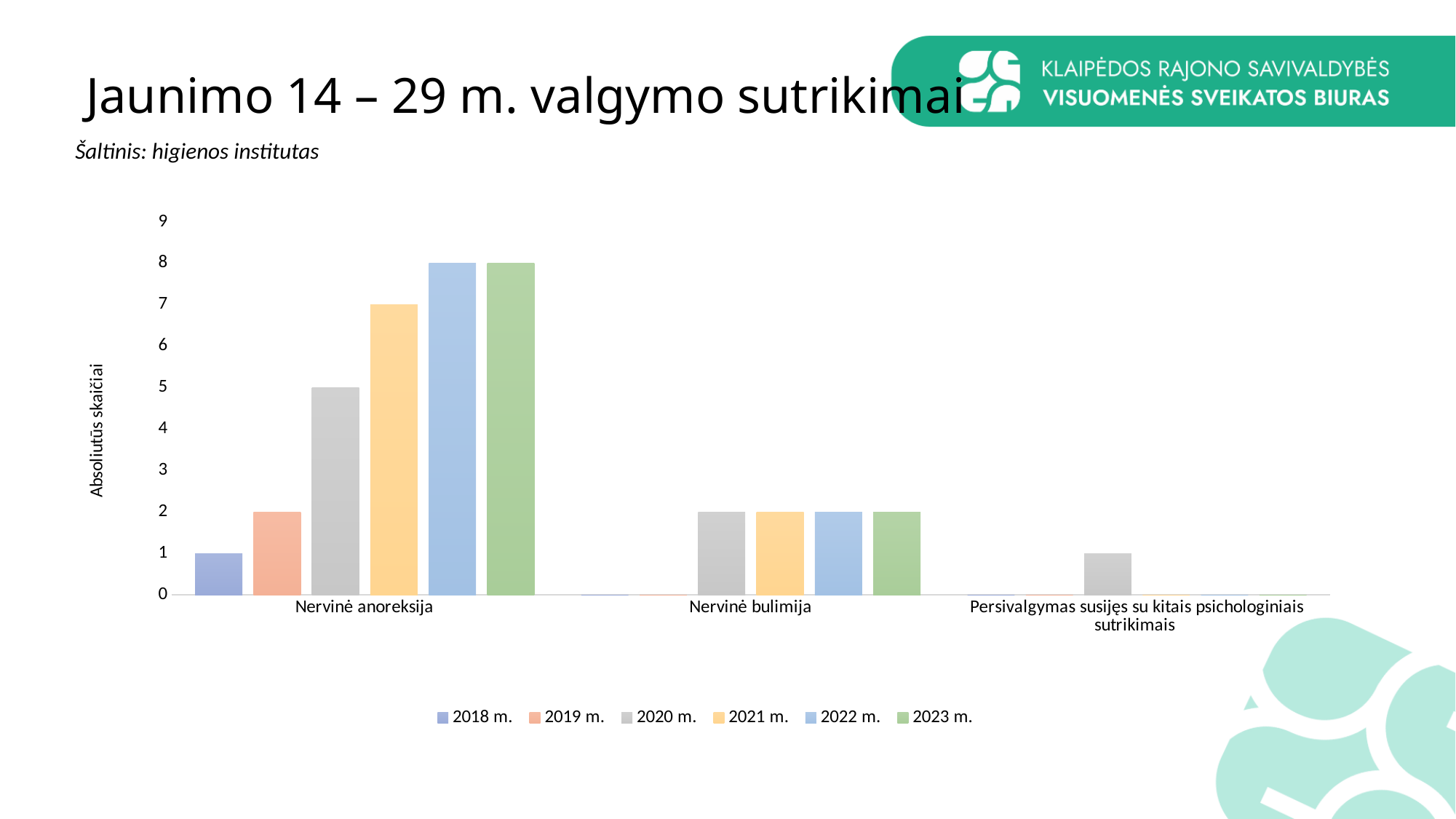
What is the difference between the 2021 m. and 2019 m. values in the Nervinė anoreksija category? 5 How many series does the legend list? 6 What is the value for 2020 m. in the Persivalgymas susijęs su kitais psichologiniais sutrikimais category? 1 What is the value for 2020 m. in the Nervinė anoreksija category? 5 Which is larger in the Nervinė anoreksija category: the 2020 m. value or the 2021 m. value? 2021 m. Which year has the lowest value in the Nervinė anoreksija category? 2018 m. What is the value for 2018 m. in the Nervinė anoreksija category? 1 What is the label of the vertical axis? Absoliutūs skaičiai Is the value for 2023 m. in the Nervinė anoreksija category greater or less than 5? greater What is the value for 2022 m. in the Nervinė anoreksija category? 8 How many categories are shown on the x axis? 3 What kind of chart is shown on the slide? bar chart